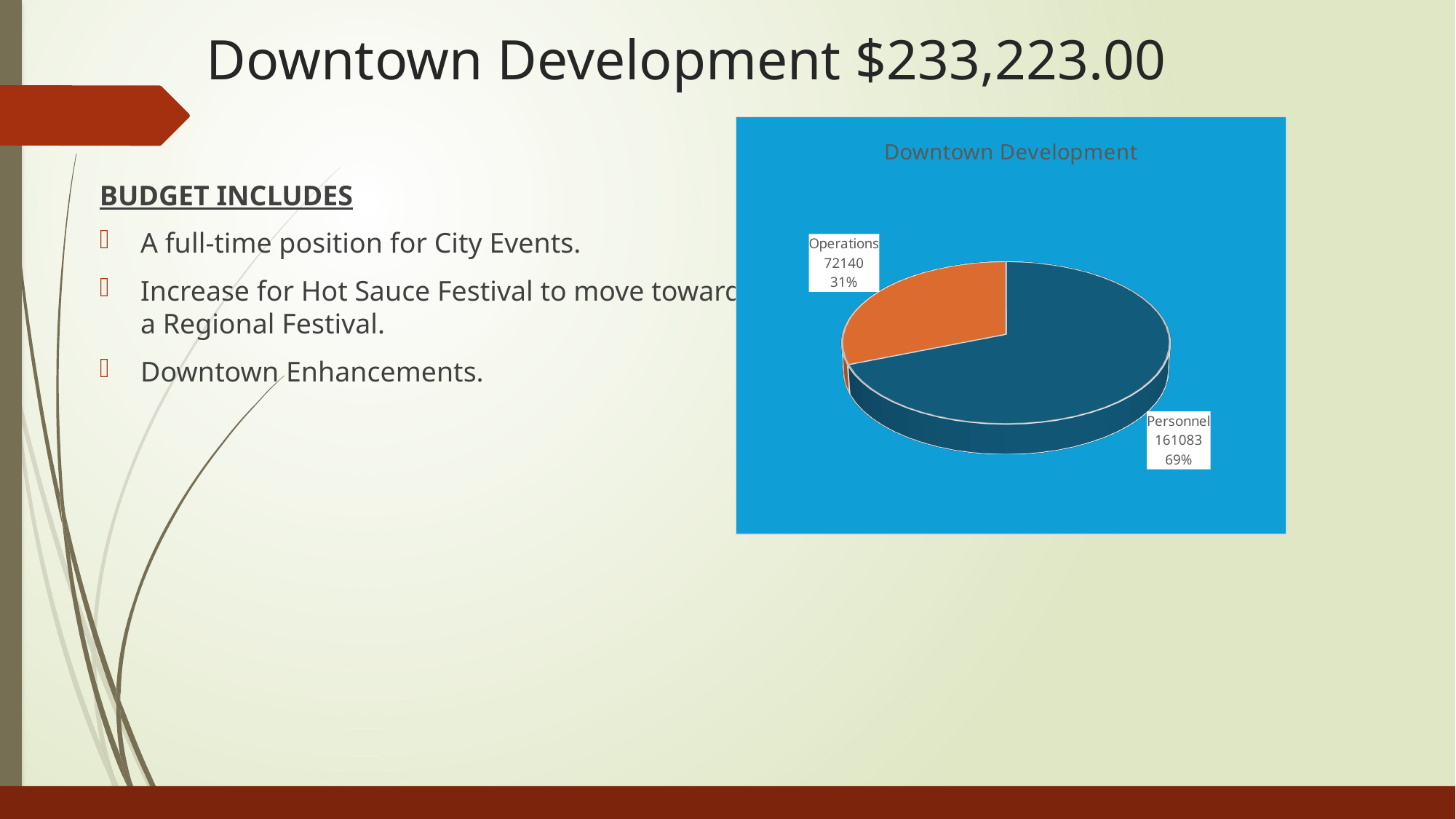
What is the difference between the Personnel and Operations values? 88943 What colour is the Operations slice? orange Which category has the largest slice? Personnel How many slices does the pie chart have? 2 What is the value for Personnel? 161083 What share of the pie does Personnel represent? 69% Which is larger, Operations or Personnel? Personnel What share of the pie does Operations represent? 31% What is the title of the chart? Downtown Development What kind of chart is shown on the slide? pie chart Which category has the smallest slice? Operations What is the value for Operations? 72140